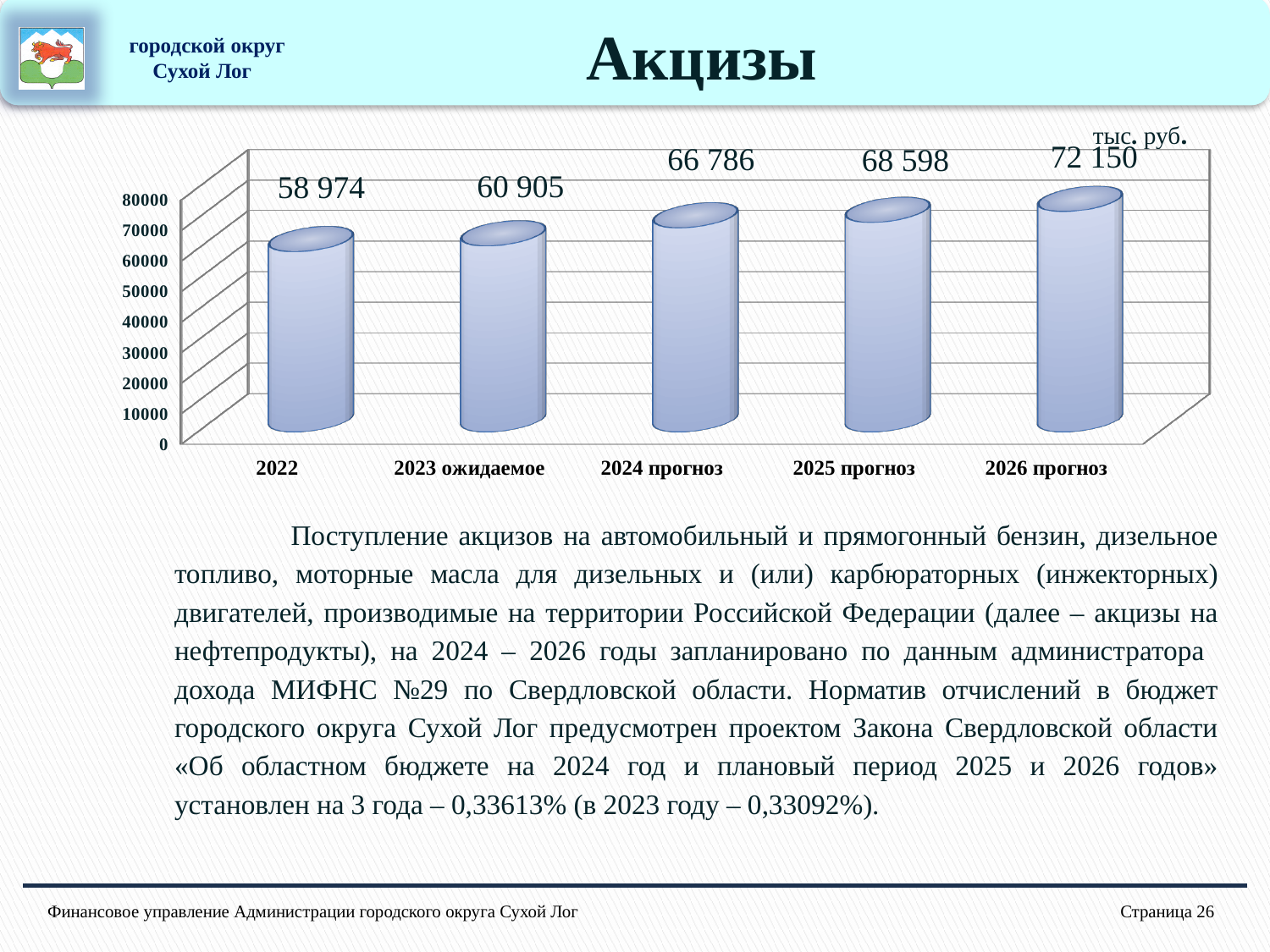
What is the difference between the values for 2024 прогноз and 2023 ожидаемое? 5 881 Which category has the lowest value? 2022 How many categories are shown on the x axis? 5 Do the values rise or fall from 2022 to 2026 прогноз? rise What is the value for 2022? 58 974 Which category has the highest value? 2026 прогноз What is the value for 2025 прогноз? 68 598 What is the difference between the values for 2026 прогноз and 2022? 13 176 What kind of chart is shown on the slide? bar chart Which is larger, the value for 2024 прогноз or the value for 2025 прогноз? 2025 прогноз Is the value for 2026 прогноз greater or less than 70000? greater What is the value for 2023 ожидаемое? 60 905